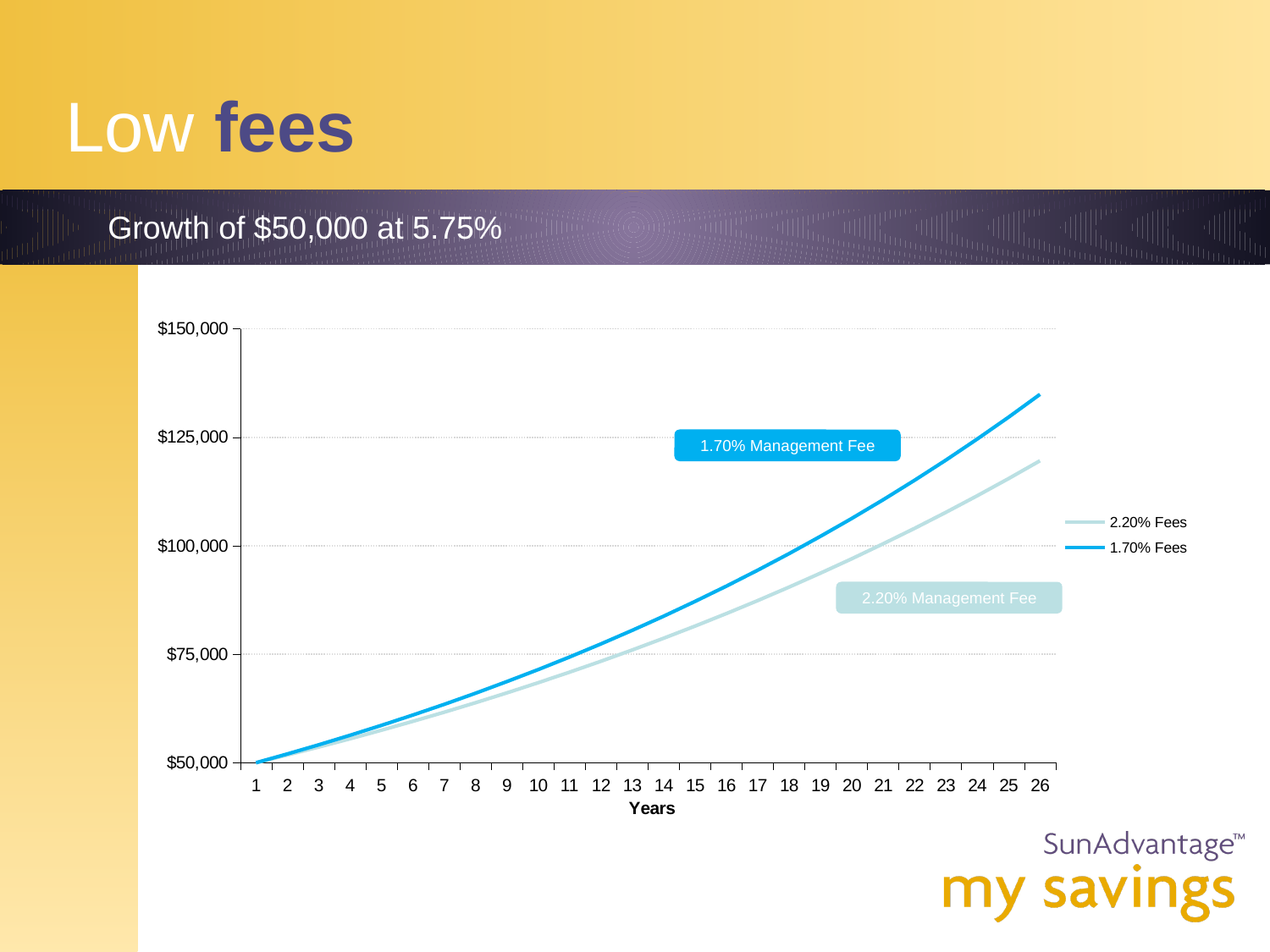
How many years are plotted along the x axis? 26 What is the title of the chart? Growth of $50,000 at 5.75% What is the value of the 1.70% Fees series at year 1? $50,000 What is the label of the x axis? Years Do the values of the 1.70% Fees series rise or fall as the years increase? rise Is the value for 2.20% Fees at year 26 greater or less than $100,000? greater Is the value for 1.70% Fees at year 10 greater or less than $75,000? less Is the value for 1.70% Fees at year 26 greater or less than $125,000? greater How many series does the legend list? 2 What kind of chart is shown on the slide? line chart Which series has the higher value at year 26, 2.20% Fees or 1.70% Fees? 1.70% Fees